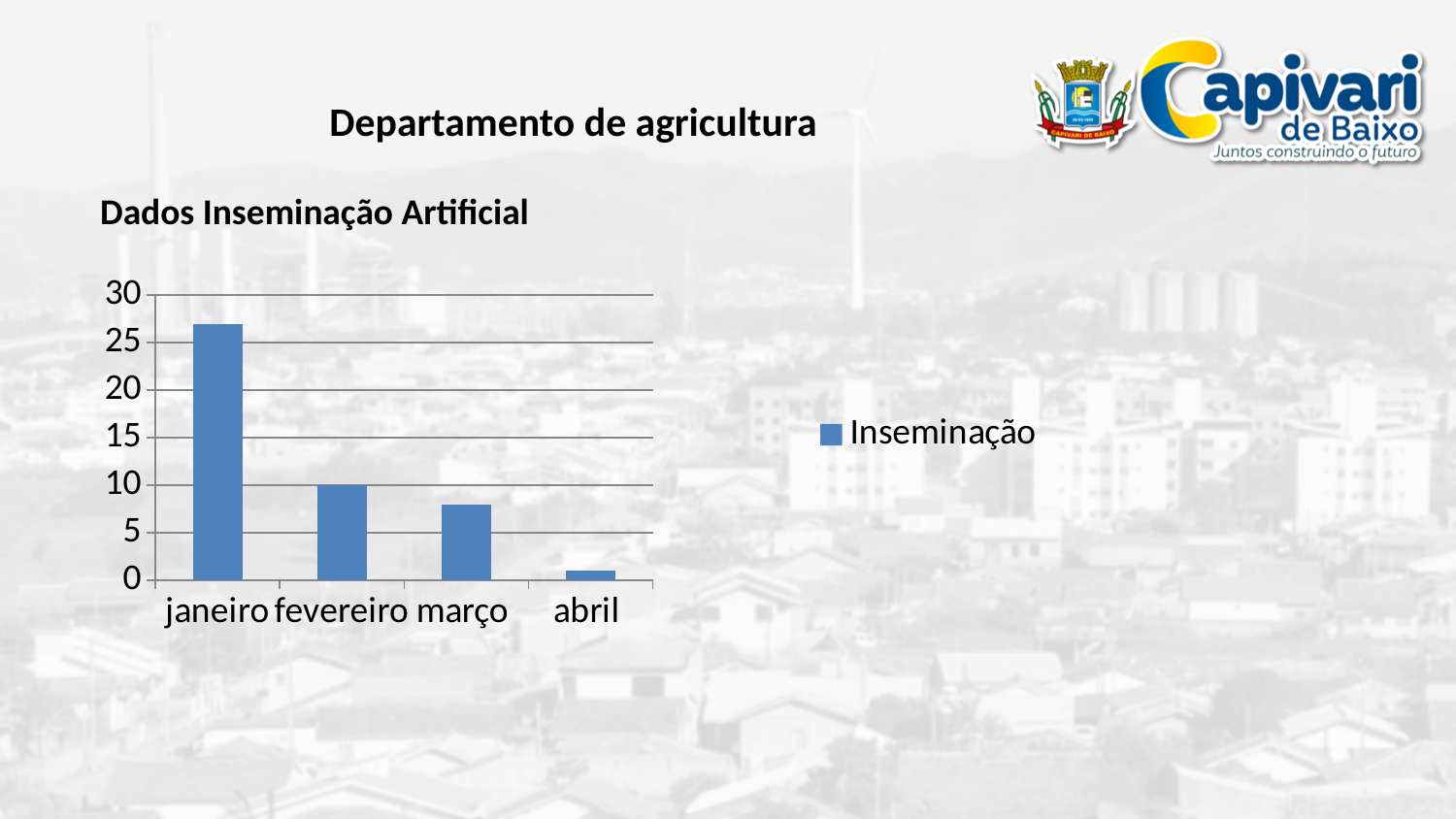
How many series does the legend list? 1 What is the value for fevereiro? 10 Which month has the highest value? janeiro What is the name of the series shown in the legend? Inseminação What kind of chart is shown on the slide? bar chart Is the value for janeiro greater or less than 25? greater Is the value for abril greater or less than 5? less Do the values rise or fall from janeiro to abril? fall How many categories are shown on the x axis? 4 What is the title of the chart? Dados Inseminação Artificial Which month has the lowest value? abril Is the value for março greater or less than 10? less